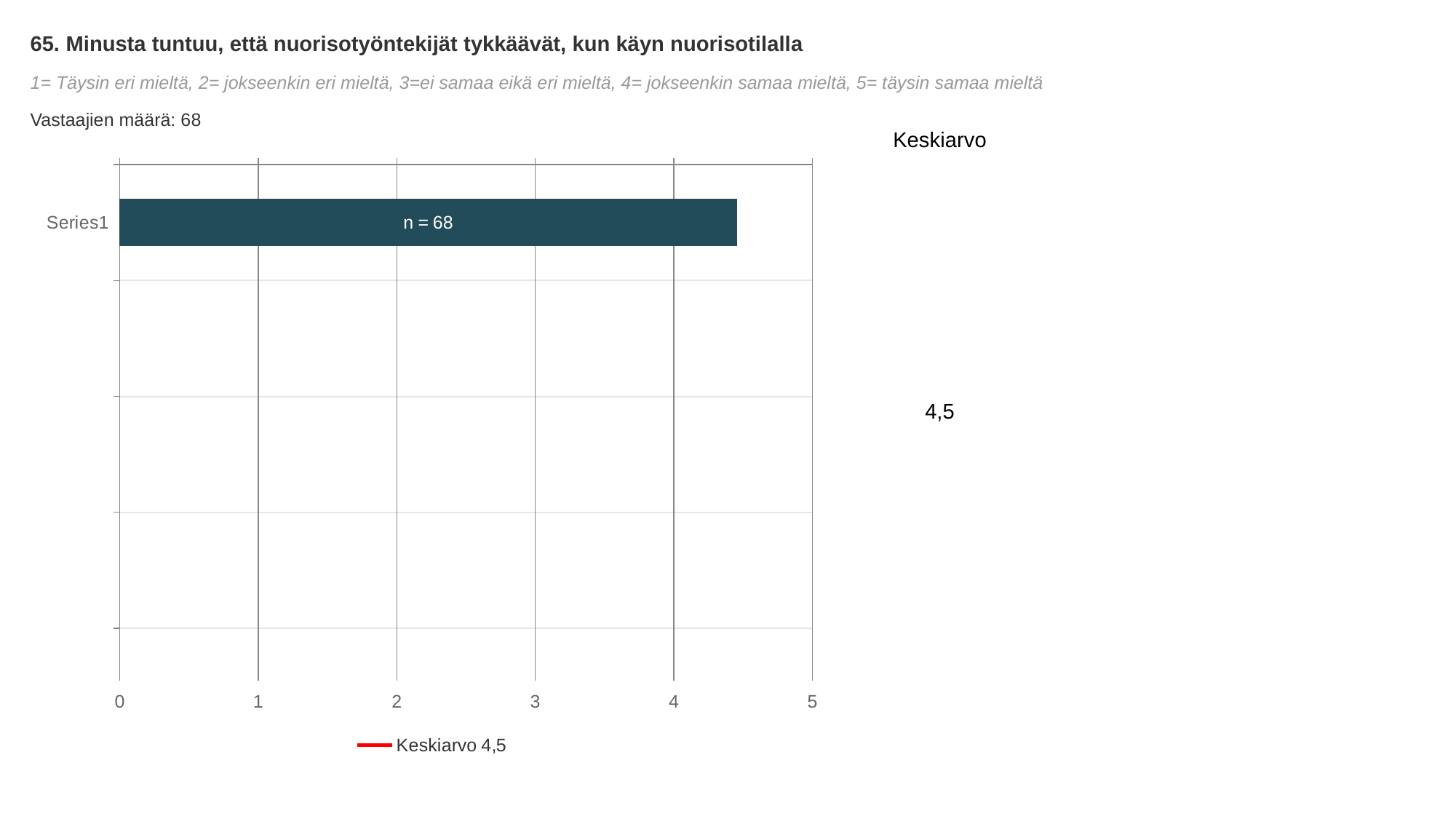
Is the value of the Series1 bar greater or less than 4? greater Is the value of the Series1 bar greater or less than 3? greater Is the value of the Series1 bar greater or less than 5? less What is the highest value shown on the x axis? 5 What kind of chart is shown on the slide? bar chart What is the Keskiarvo (mean) value shown on the slide? 4,5 What is the number of respondents (Vastaajien määrä) stated on the slide? 68 How many bars are plotted in the chart? 1 How many entries does the legend list? 1 What data label is printed on the Series1 bar? n = 68 What text does the legend entry show? Keskiarvo 4,5